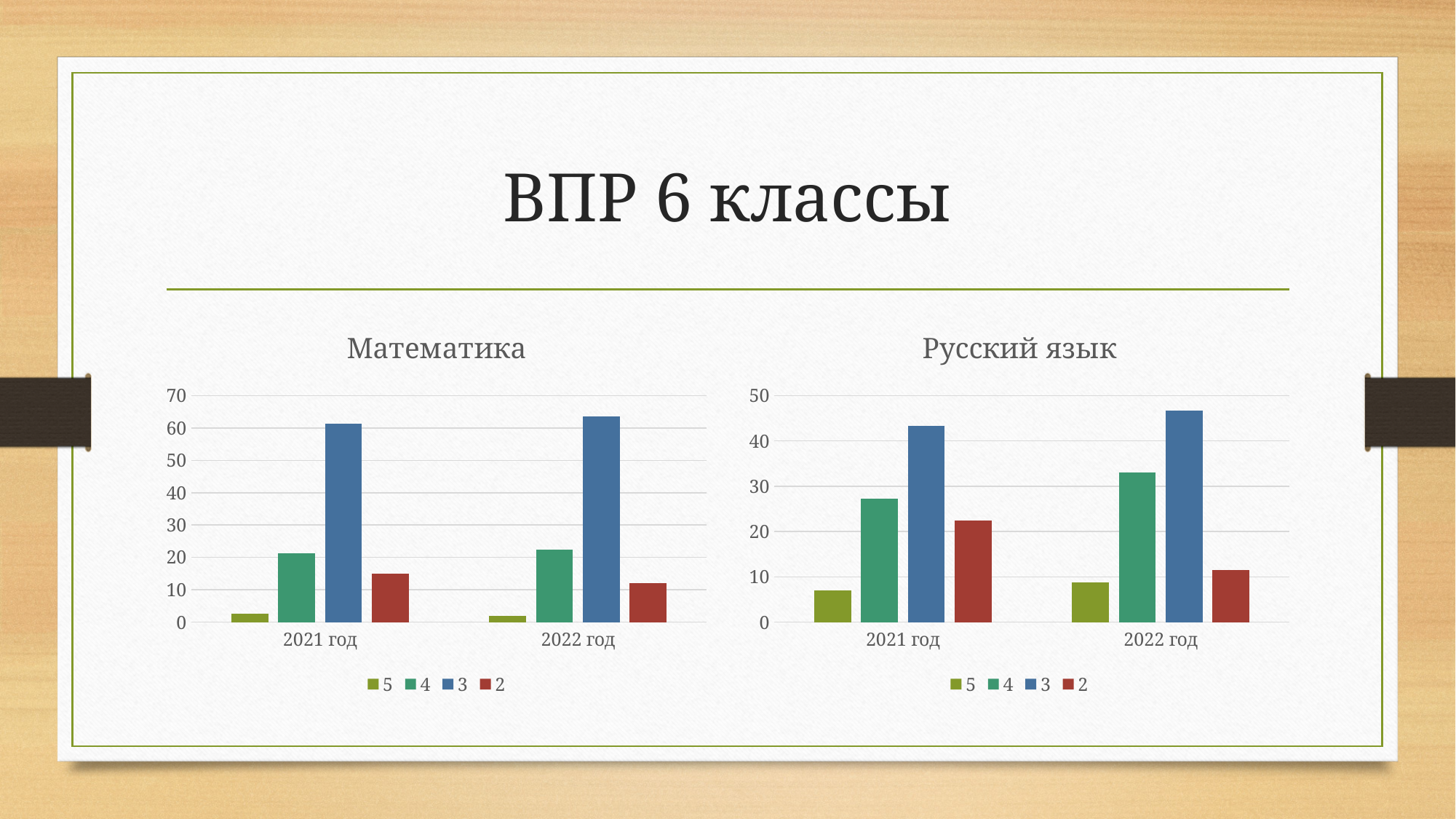
What is the title of the chart on the right side of the slide? Русский язык In the "Русский язык" chart, does the value of series 2 rise or fall from 2021 год to 2022 год? fall How many series does the legend of the "Русский язык" chart list? 4 In the "Русский язык" chart, is the value of series 2 for 2022 год greater or less than 20? less In the "Математика" chart, is the value of series 3 for 2021 год greater or less than 50? greater In the "Русский язык" chart, which is larger for series 4: 2021 год or 2022 год? 2022 год In the "Русский язык" chart, which series has the lowest bar for 2021 год? 5 What kind of chart is the "Математика" chart? bar chart In the "Математика" chart, which series has the lowest bar for 2022 год? 5 In the "Математика" chart, which series has the highest bar for 2021 год? 3 How many categories are shown on the x axis of the "Математика" chart? 2 In the "Русский язык" chart, which series has the highest bar for 2022 год? 3